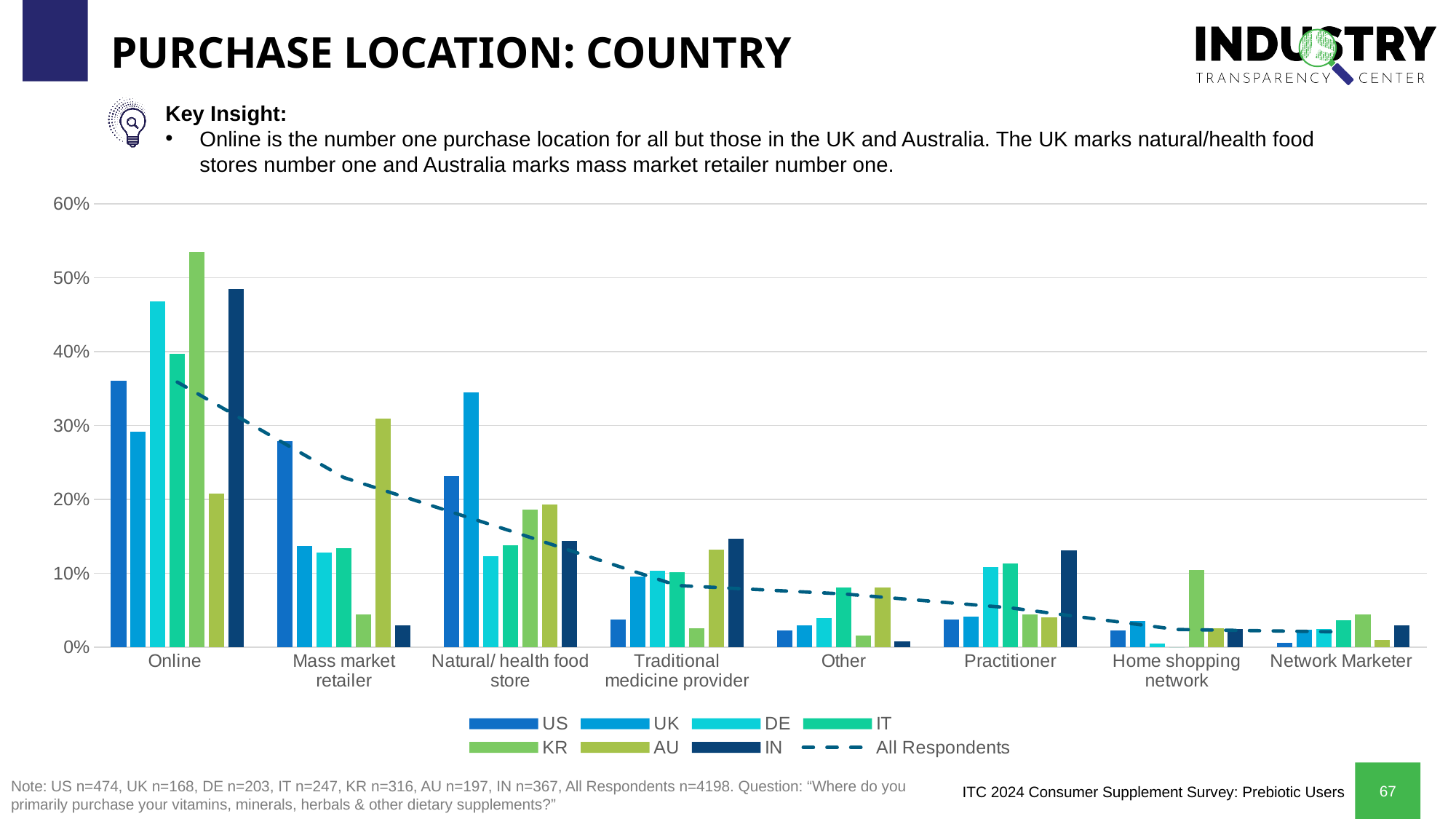
Does the dashed All Respondents line rise or fall from left to right across the categories? fall Which country has the highest value for Natural/ health food store? UK Is the value for KR in the Online category greater or less than 50%? greater Which country has the highest value for Online? KR What kind of chart is shown on the slide? combination bar and line chart Is the value for UK in the Natural/ health food store category greater or less than 30%? greater Is the value for AU in the Online category greater or less than 30%? less How many purchase location categories are shown along the x axis? 8 Which country has the highest value for Home shopping network? KR How many entries does the chart legend list? 8 In the Online category, which is larger, the value for US or the value for UK? US